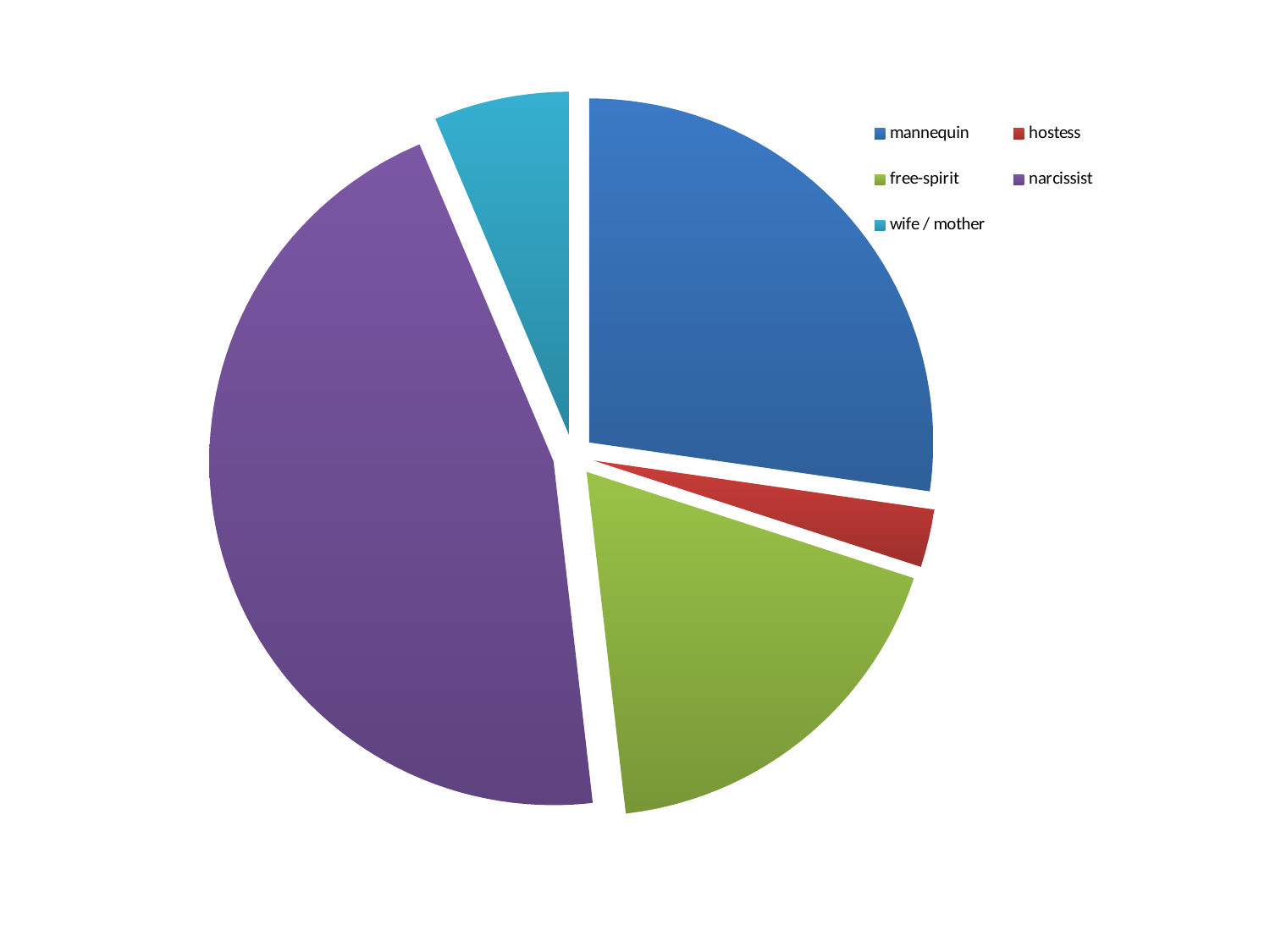
Which slice is larger, mannequin or free-spirit? mannequin Which slice is larger, wife / mother or hostess? wife / mother Which slice is larger, free-spirit or wife / mother? free-spirit Which category is shown in red in the legend? hostess What colour is the narcissist slice? purple Which category has the smallest slice of the pie? hostess What kind of chart is shown on the slide? pie chart How many entries does the legend list? 5 How many slices does the pie chart have? 5 Which category has the largest slice of the pie? narcissist